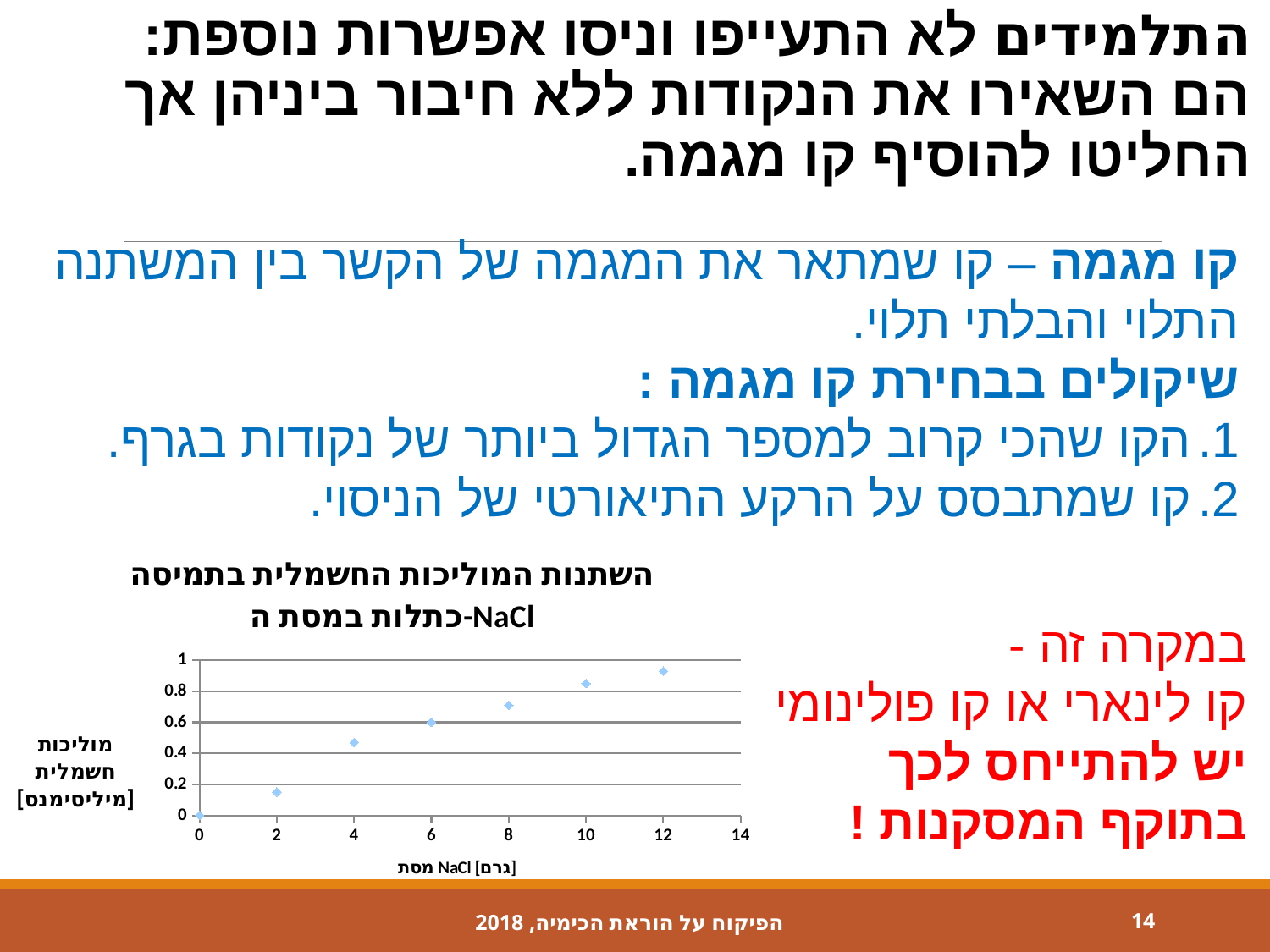
How many data points are plotted in the chart? 7 At which NaCl mass is the plotted conductivity highest? 12 Is the plotted value at NaCl mass 2 greater or less than 0.2? less What is the plotted conductivity value at NaCl mass 0? 0 Is the plotted value at NaCl mass 12 greater or less than 1? less Is the plotted value at NaCl mass 4 greater or less than 0.4? greater Do the plotted values rise or fall as the NaCl mass increases along the x axis? rise What kind of chart is shown on the slide? scatter chart Which has the larger plotted value: NaCl mass 4 or NaCl mass 10? 10 At which NaCl mass is the plotted conductivity lowest? 0 What is the label of the x axis of the chart? מסת NaCl [גרם]